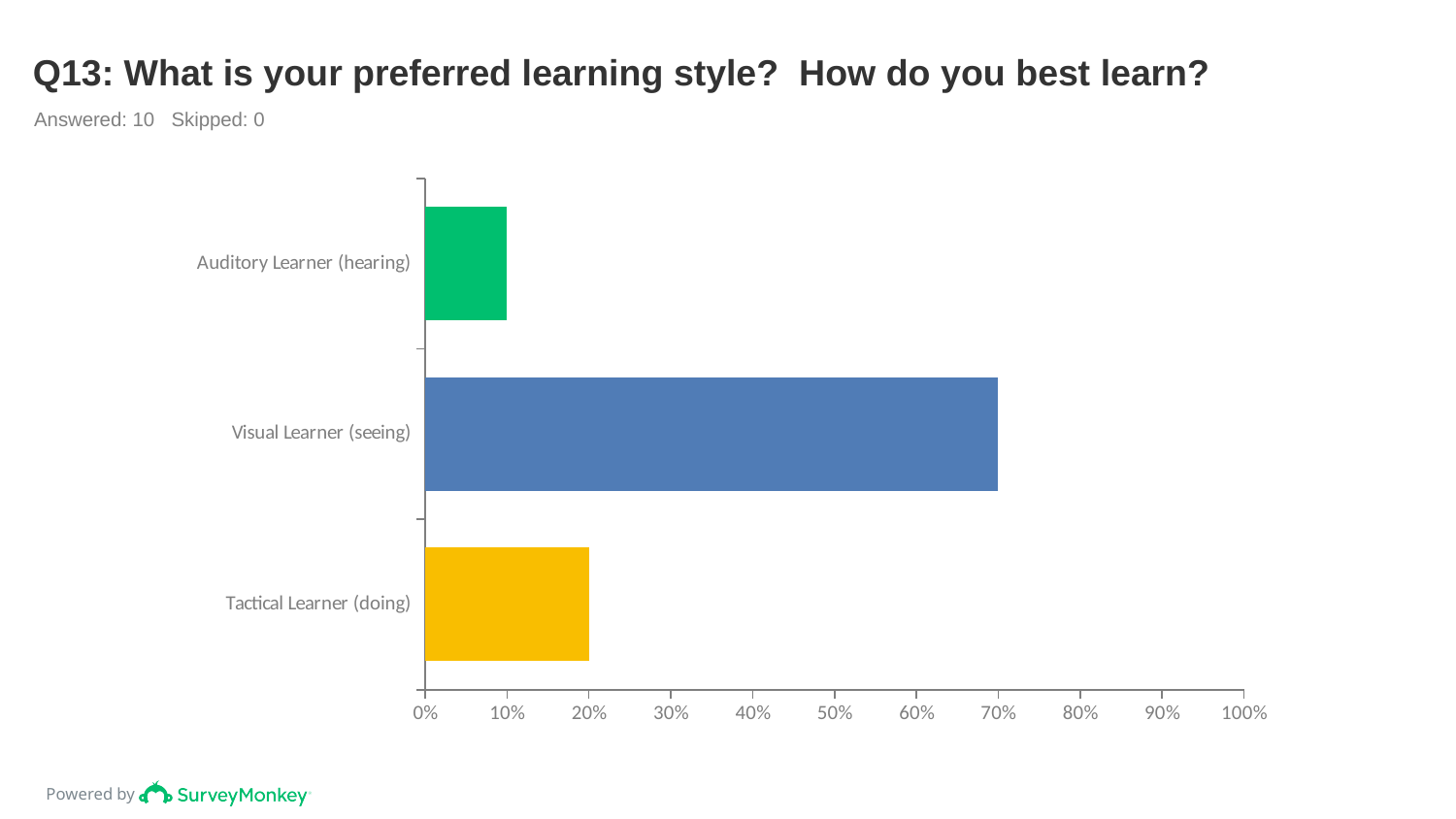
How many respondents answered the question according to the slide? 10 How many categories are shown in the chart? 3 What kind of chart is shown on the slide? Bar chart What is the difference between the values for Tactical Learner (doing) and Auditory Learner (hearing)? 10% Which learning style has the highest value? Visual Learner (seeing) What is the difference between the values for Visual Learner (seeing) and Tactical Learner (doing)? 50% What is the value for Tactical Learner (doing)? 20% Which learning style has the lowest value? Auditory Learner (hearing) Is the value for Visual Learner (seeing) greater or less than 50%? greater What is the value for Auditory Learner (hearing)? 10% What is the value for Visual Learner (seeing)? 70% Which is larger, the value for Tactical Learner (doing) or Auditory Learner (hearing)? Tactical Learner (doing)